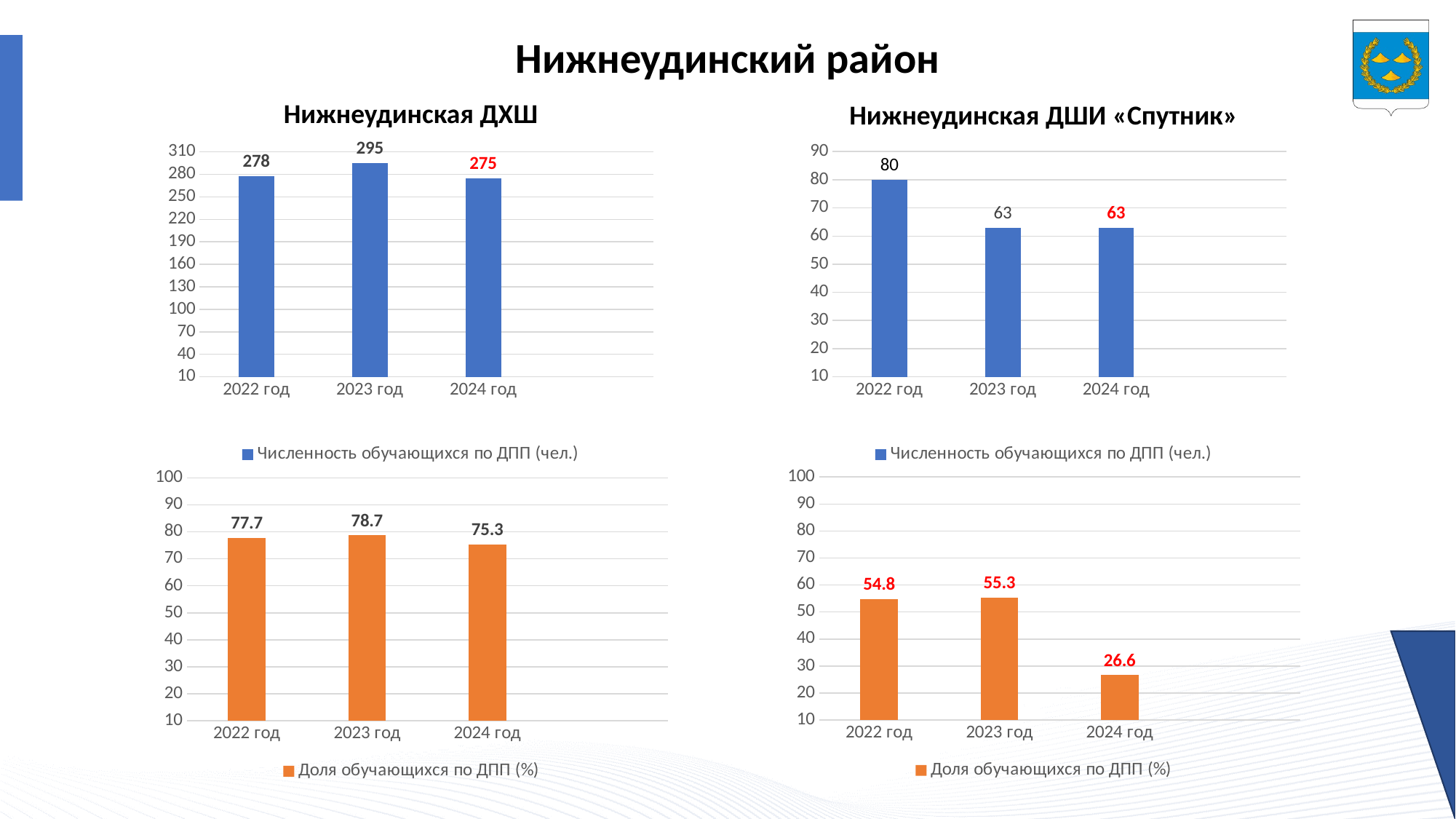
What kind of chart is the top-left chart titled «Нижнеудинская ДХШ»? bar chart What is the legend entry of the bottom-right chart? Доля обучающихся по ДПП (%) In the top-right chart titled «Нижнеудинская ДШИ «Спутник»», how many bars are plotted? 3 In the bottom-left chart (Доля обучающихся по ДПП (%) for Нижнеудинская ДХШ), what is the value for 2024 год? 75.3 In the bottom-left chart (Доля обучающихся по ДПП (%) for Нижнеудинская ДХШ), which year has the highest value? 2023 год In the bottom-right chart (Доля обучающихся по ДПП (%) for Нижнеудинская ДШИ «Спутник»), what is the value for 2024 год? 26.6 In the top-right chart titled «Нижнеудинская ДШИ «Спутник»», what is the difference between the 2022 год and 2023 год values? 17 In the bottom-right chart (Доля обучающихся по ДПП (%) for Нижнеудинская ДШИ «Спутник»), is the value for 2022 год larger or smaller than the value for 2024 год? larger In the top-right chart titled «Нижнеудинская ДШИ «Спутник»», what is the value for 2022 год? 80 In the top-left chart titled «Нижнеудинская ДХШ», what is the difference between the 2023 год and 2024 год values? 20 In the top-left chart titled «Нижнеудинская ДХШ», what is the value for 2023 год? 295 In the top-left chart titled «Нижнеудинская ДХШ», which year has the lowest value? 2024 год